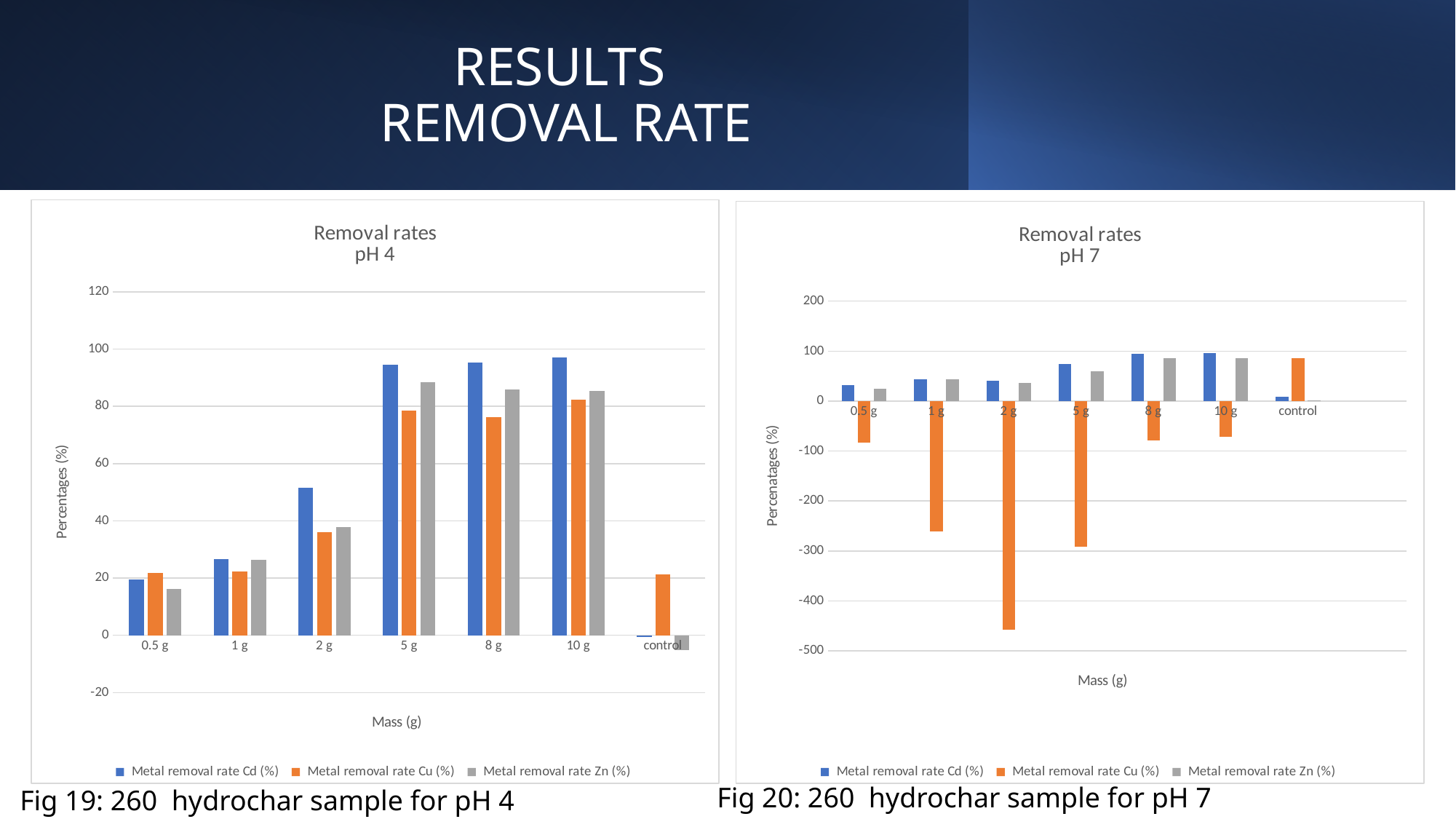
What is the x-axis title of the 'Removal rates pH 7' chart? Mass (g) What kind of chart is the 'Removal rates pH 4' chart? bar chart In the 'Removal rates pH 7' chart, is the value for Metal removal rate Cu (%) at 5 g greater or less than -200? less In the 'Removal rates pH 4' chart, is the value for Metal removal rate Zn (%) at 0.5 g greater or less than 20? less In the 'Removal rates pH 4' chart, which category has the lowest value for Metal removal rate Zn (%)? control How many mass categories are shown on the x axis of the 'Removal rates pH 4' chart? 7 In the 'Removal rates pH 4' chart, does Metal removal rate Cd (%) rise or fall from 0.5 g to 10 g? rise In the 'Removal rates pH 7' chart, is the value for Metal removal rate Cu (%) at 2 g greater or less than -400? less In the 'Removal rates pH 4' chart, which is larger at 2 g: Metal removal rate Cd (%) or Metal removal rate Cu (%)? Metal removal rate Cd (%) How many series does the legend of the 'Removal rates pH 7' chart list? 3 In the 'Removal rates pH 7' chart, which category has the lowest value for Metal removal rate Cu (%)? 2 g